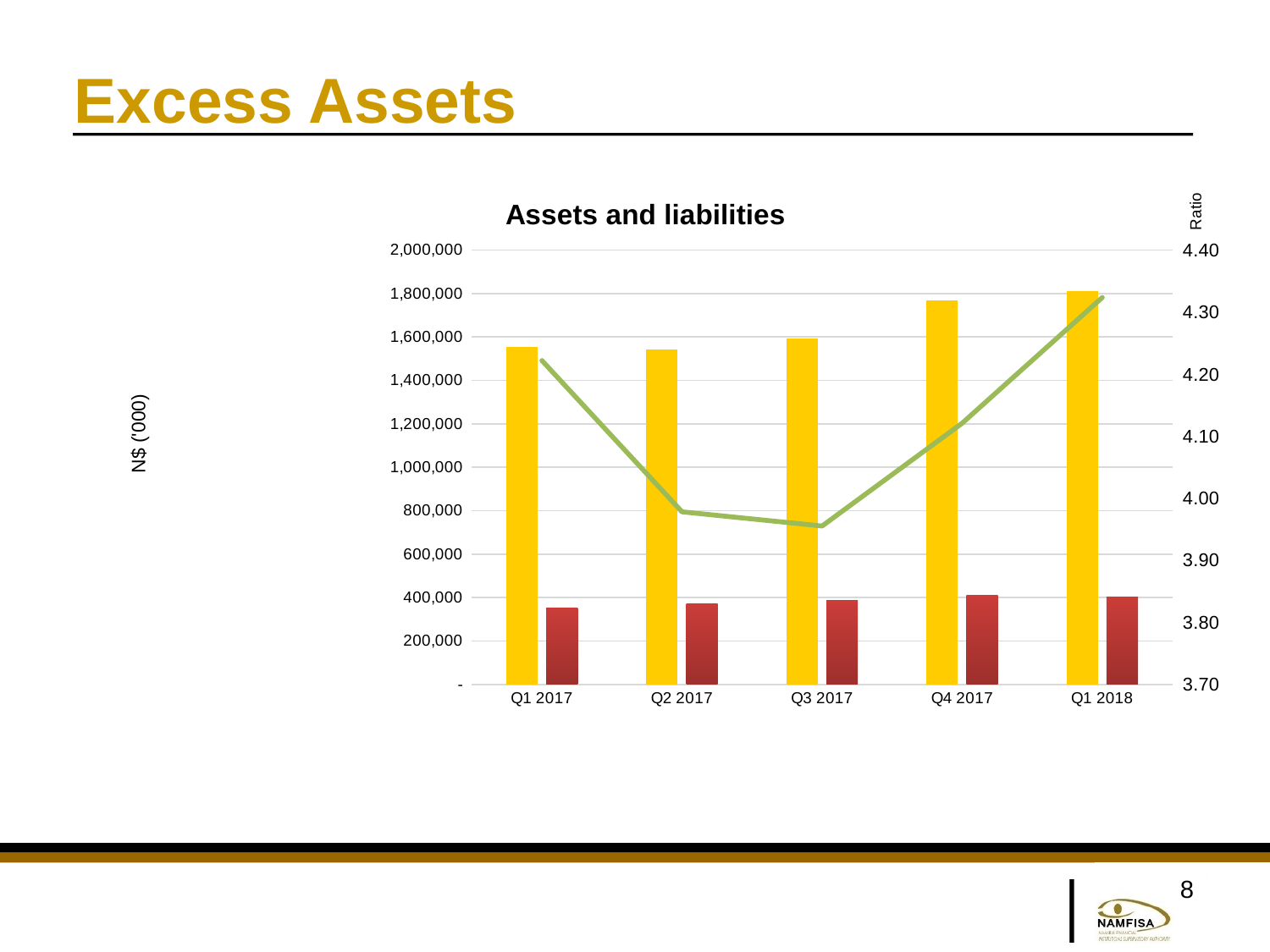
What is the title of the chart? Assets and liabilities In which quarter is the yellow bar the highest? Q1 2018 Is the yellow bar for Q1 2017 greater or less than 1,400,000? greater How many quarters are shown on the x axis of the chart? 5 Is the green line value for Q3 2017 greater or less than 4.00? less In which quarter does the green line reach its highest point? Q1 2018 Is the red bar for Q1 2017 greater or less than 400,000? less What is the label of the right-hand vertical axis? Ratio Which is larger, the yellow bar for Q4 2017 or the yellow bar for Q3 2017? Q4 2017 What kind of chart is shown on the slide? Combined bar and line chart